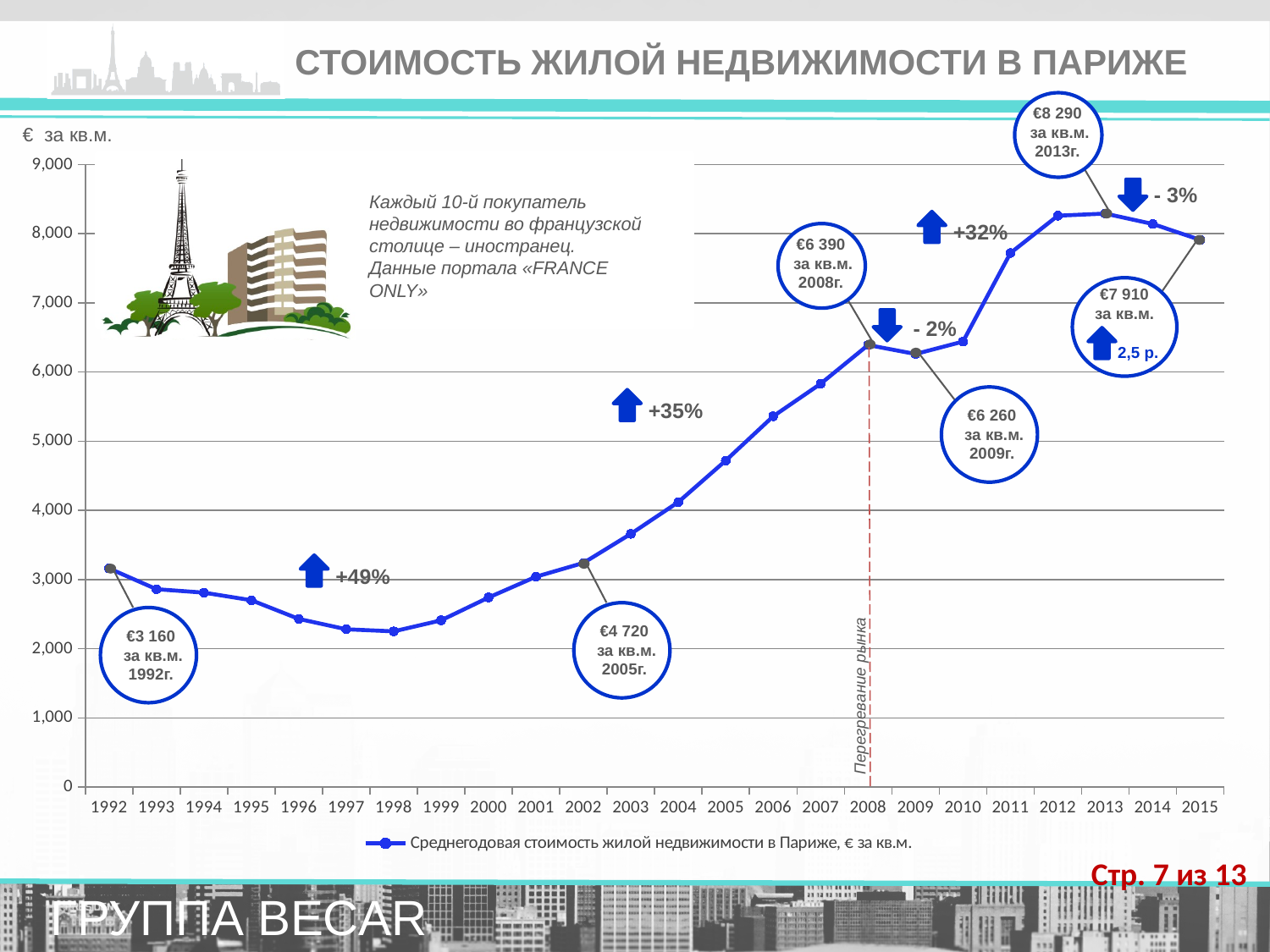
Is the value for 2011 greater or less than 7,000? greater How many series does the legend list? 1 What was the average cost of residential property in Paris in 1992, according to the callout? €3 160 за кв.м. Is the value for 2000 greater or less than 3,000? less What value does the callout give for 2013? €8 290 за кв.м. By how much did the value in 2013 exceed the value in 2008, using the callout figures? €1 900 Which year had the higher value, 2008 or 2009? 2008 How many years are plotted on the x axis? 24 What label is written next to the dashed vertical line at 2008? Перегревание рынка What type of chart is shown on the slide? Line chart What value does the callout give for 2008? €6 390 за кв.м. What value does the callout give for 2005? €4 720 за кв.м.